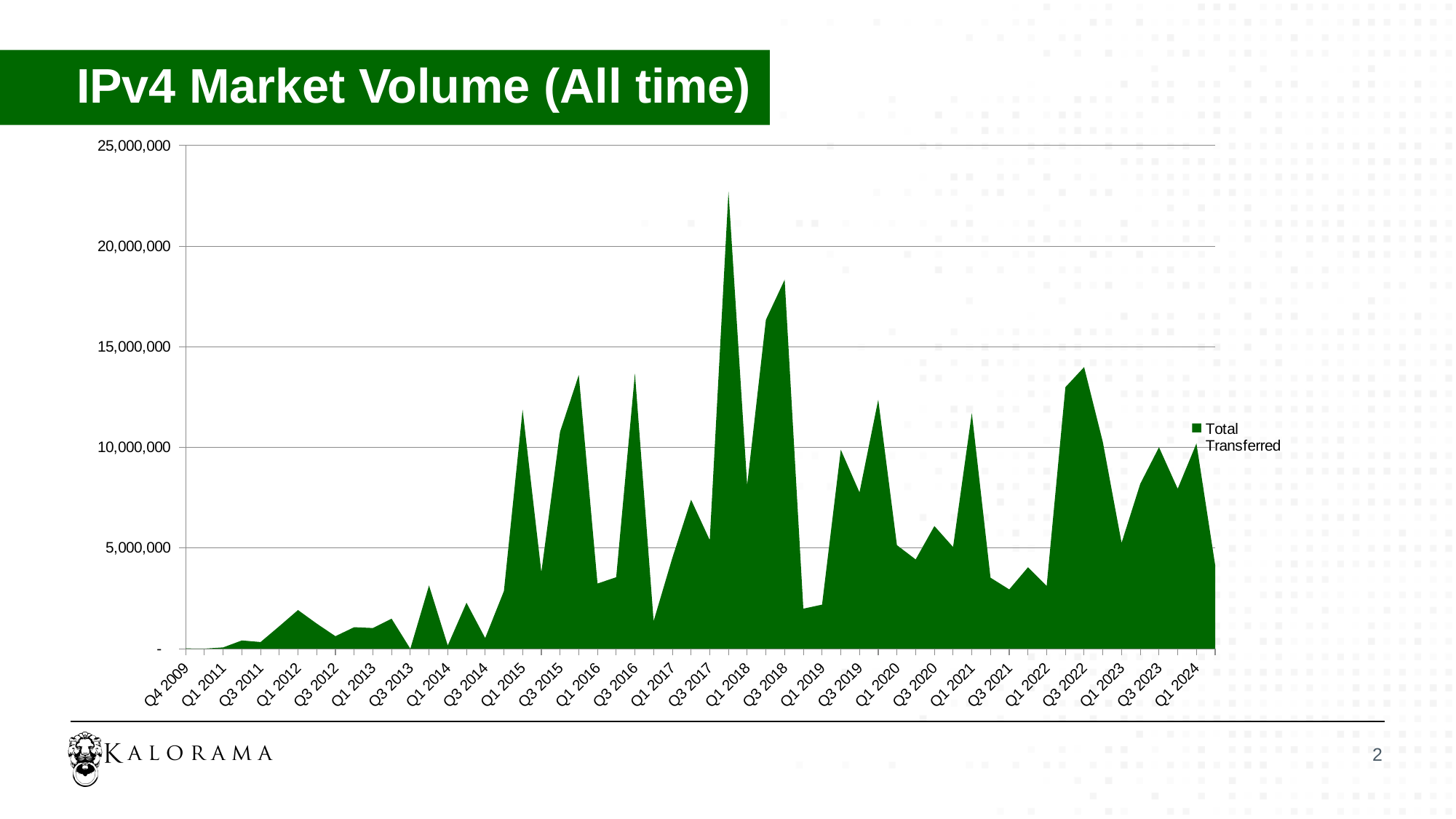
How many series does the legend list? 1 What kind of chart is shown on the slide? area chart Is the value for Q1 2018 greater or less than 20,000,000? less How many quarter labels are shown on the x axis? 28 Which is larger, the value for Q1 2018 or the value for Q3 2018? Q3 2018 What is the name of the series shown in the legend? Total Transferred Is the value for Q3 2022 greater or less than 10,000,000? greater What is the title of the chart? IPv4 Market Volume (All time) Is the value for Q3 2018 greater or less than 15,000,000? greater